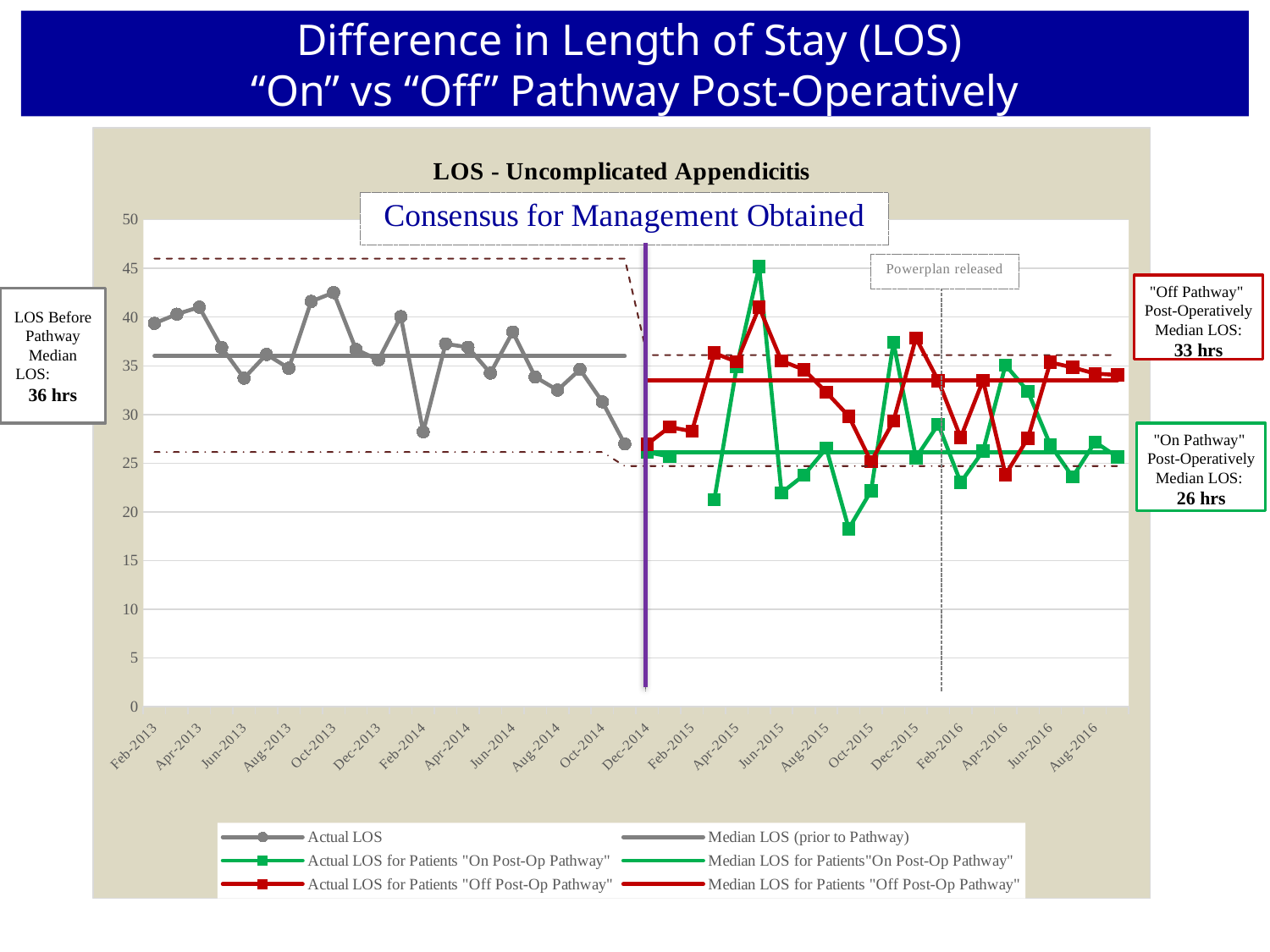
What is the difference between the median LOS before the pathway and the "On Pathway" post-operative median LOS? 10 hrs What is the median LOS before the pathway, as stated on the slide? 36 hrs What is the title of the chart? LOS - Uncomplicated Appendicitis Which is larger, the "Off Pathway" post-operative median LOS or the "On Pathway" post-operative median LOS? "Off Pathway" post-operative median LOS What is the post-operative median LOS for patients "Off Pathway"? 33 hrs What is the post-operative median LOS for patients "On Pathway"? 26 hrs Is the Actual LOS for Patients "On Post-Op Pathway" value at Jun-2015 greater or less than 40? less How many series does the chart legend list? 6 Is the Actual LOS for Patients "On Post-Op Pathway" value at Sep-2015 greater or less than 20? less What kind of chart is shown on the slide? line chart At which month does the Actual LOS for Patients "On Post-Op Pathway" series reach its highest value? May-2015 What is the difference between the "Off Pathway" and "On Pathway" post-operative median LOS values? 7 hrs